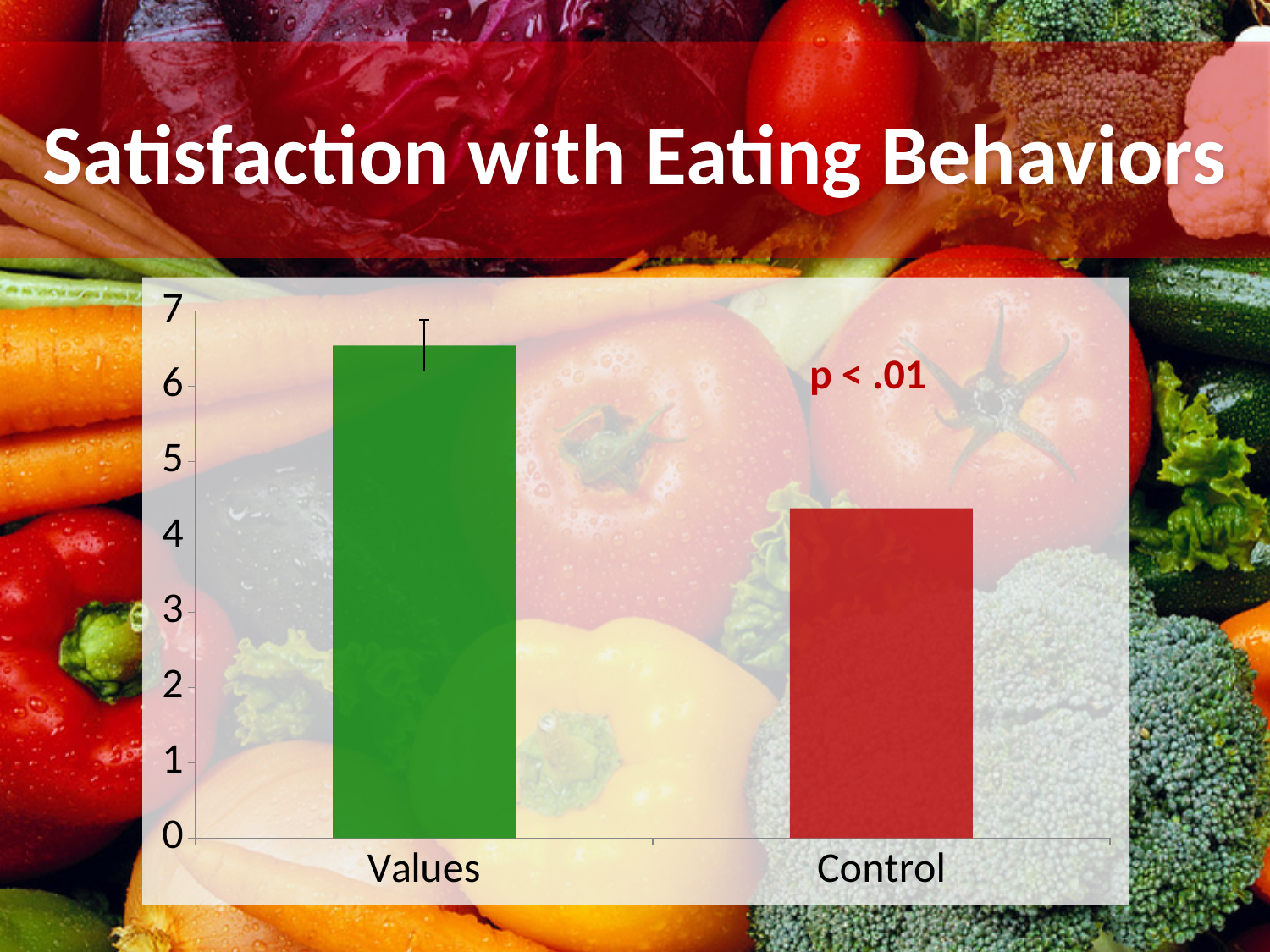
Which category has the lowest value? Control Is the value for Control greater or less than 4? greater What kind of chart is shown on the slide? bar chart Is the value for Values greater or less than 6? greater Is the value for Control greater or less than 5? less What is the maximum value shown on the y axis? 7 What is the title of the slide containing the chart? Satisfaction with Eating Behaviors How many categories are shown on the x axis? 2 Which category has the highest value? Values Which is larger, the value for Values or the value for Control? Values What p-value annotation is shown on the chart? p < .01